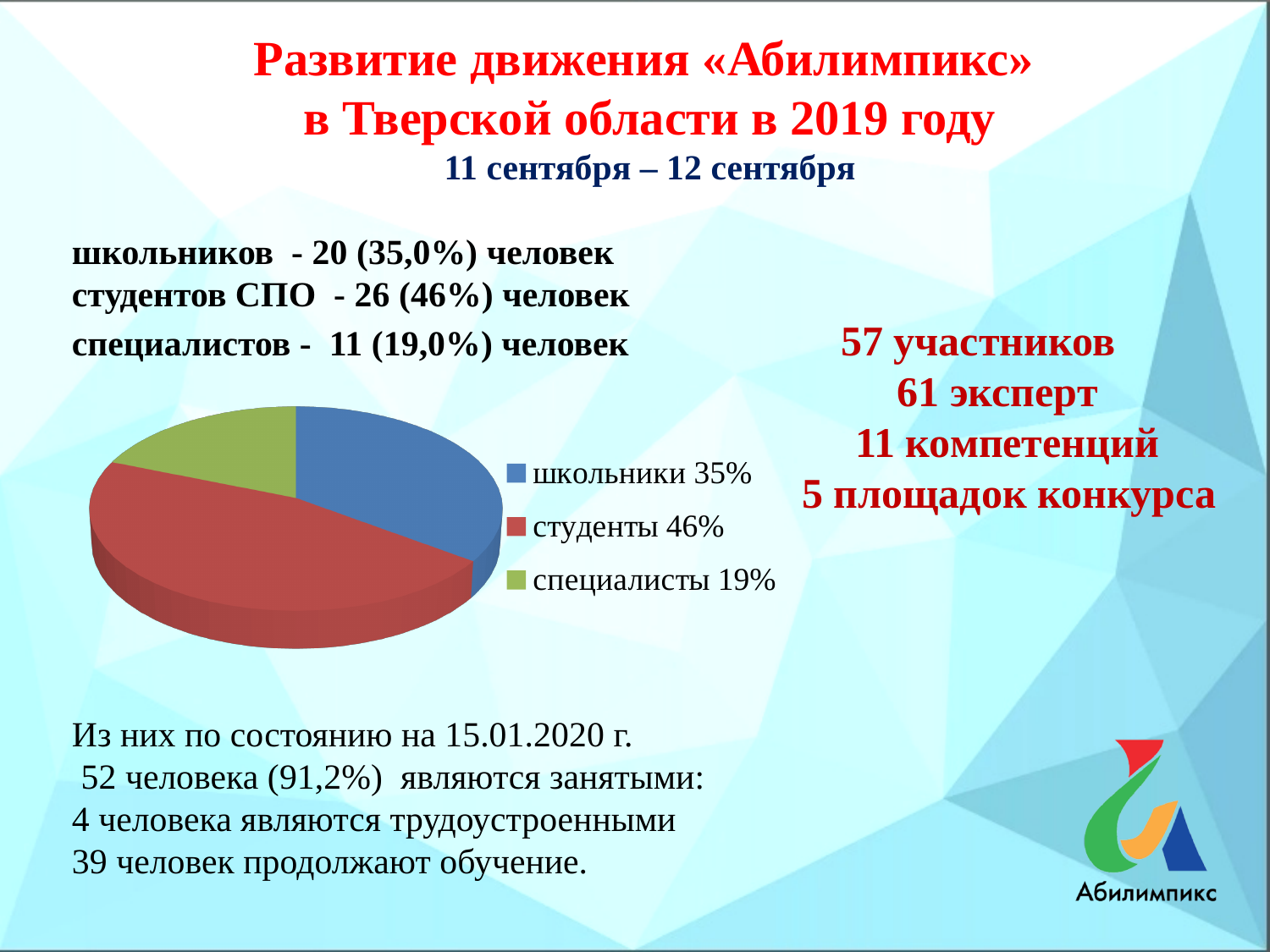
What share of the pie does the студенты slice represent? 46% How many entries does the legend of the pie chart list? 3 What share of the pie does the специалисты slice represent? 19% What colour is the студенты slice in the pie chart? red By how many percentage points does the студенты share exceed the школьники share? 11 What kind of chart is shown on the slide? pie chart Which category has the largest slice in the pie chart? студенты What share of the pie does the школьники slice represent? 35% How many slices does the pie chart have? 3 Which slice is larger, школьники or специалисты? школьники Which category has the smallest slice in the pie chart? специалисты What colour is the специалисты slice in the pie chart? green